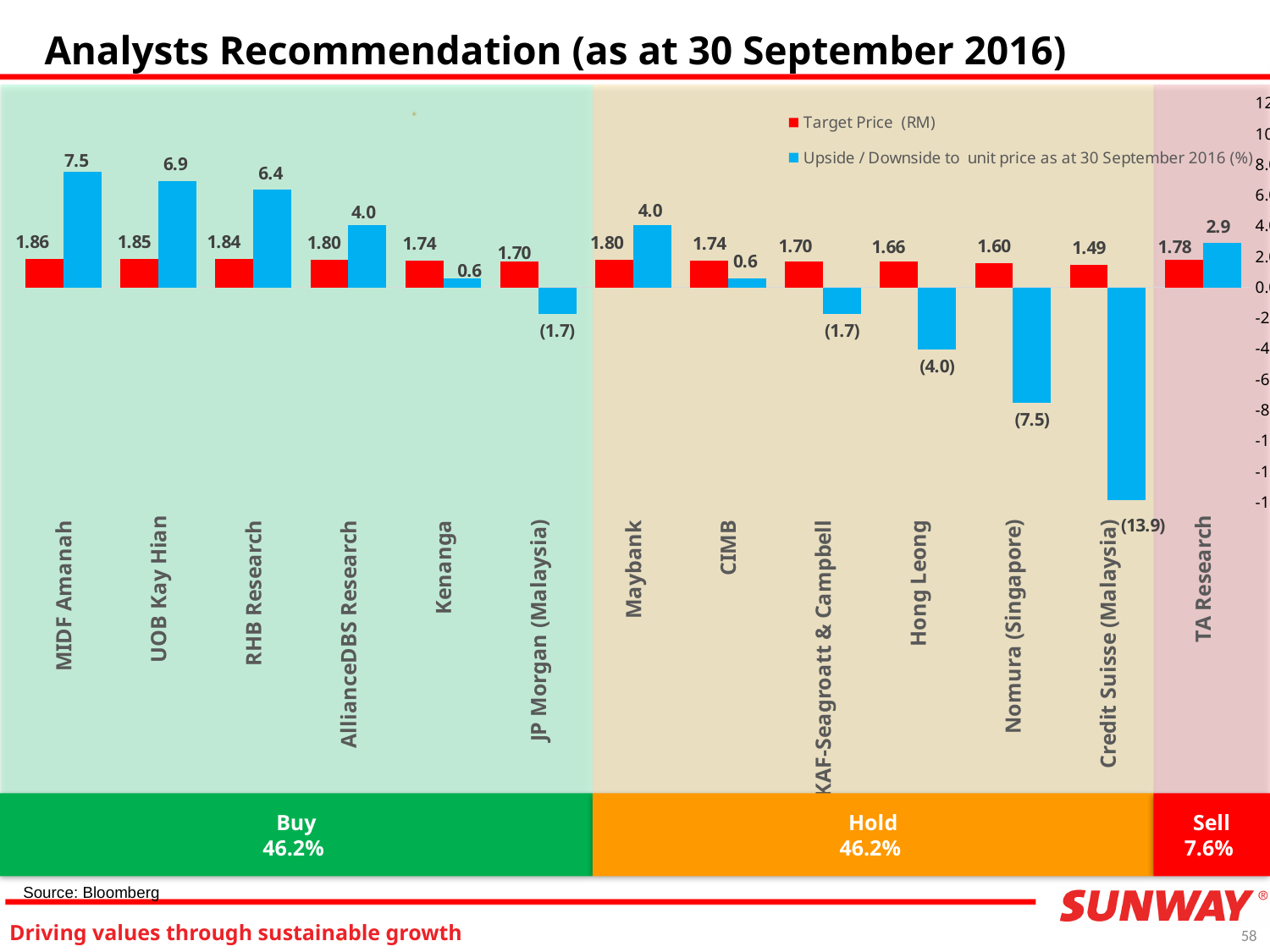
Which analyst has the highest upside/downside (%) value? MIDF Amanah What is the difference between the target price of MIDF Amanah and that of Credit Suisse (Malaysia)? 0.37 Which has a higher target price, Hong Leong or Nomura (Singapore)? Hong Leong How many series does the legend list? 2 What is the target price (RM) for MIDF Amanah? 1.86 How many analysts are shown on the chart? 13 What is the target price (RM) for TA Research? 1.78 What is the upside/downside (%) shown for Credit Suisse (Malaysia)? (13.9) What percentage of analysts have a Sell recommendation? 7.6% Which colour represents Target Price (RM) in the legend? Red What kind of chart is shown on the slide? Bar chart Which analyst has the lowest target price (RM)? Credit Suisse (Malaysia)